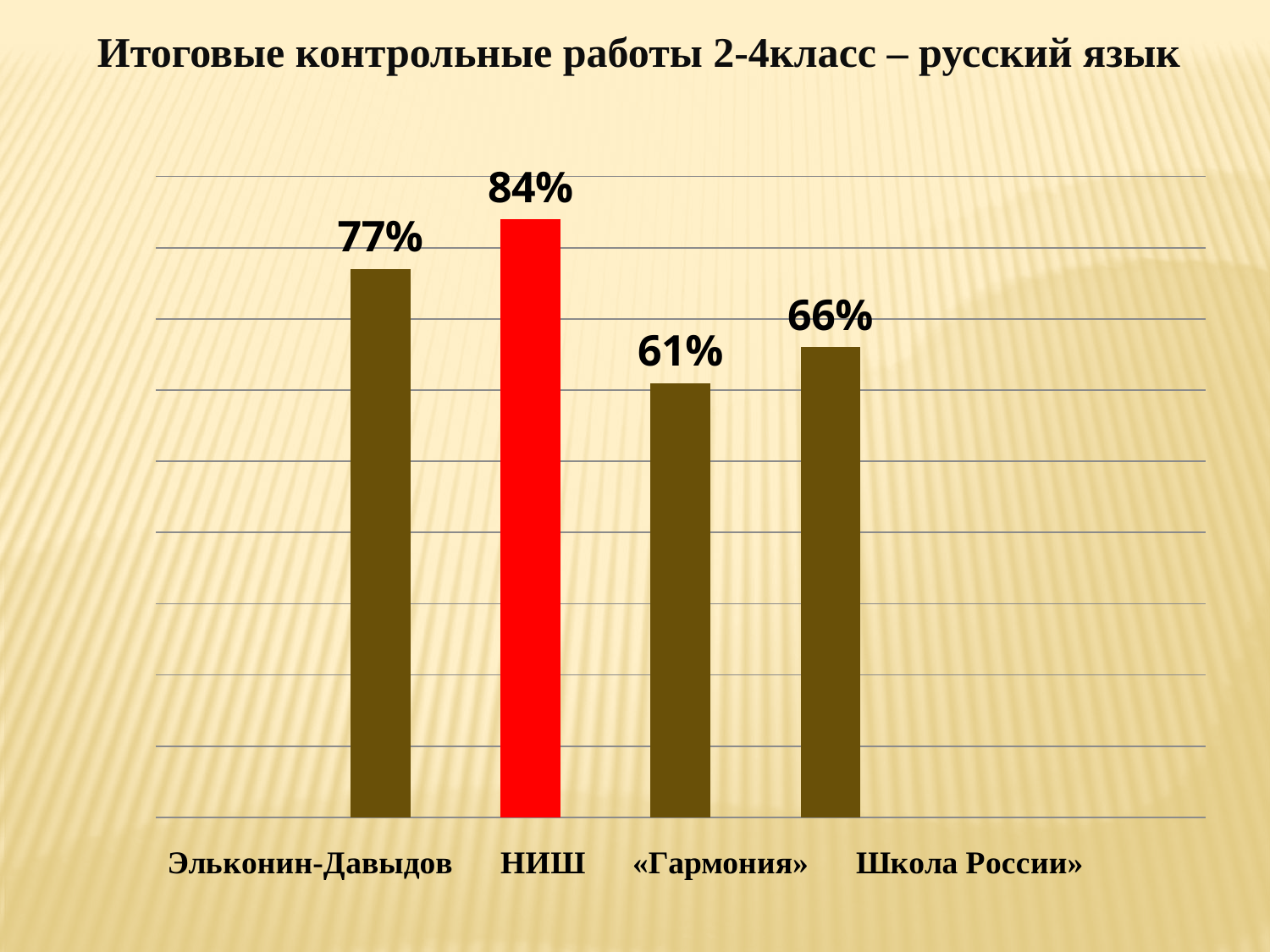
What is the difference between the values for НИШ and Эльконин-Давыдов? 7% What kind of chart is shown on the slide? bar chart How many categories are shown in the chart? 4 What is the value for «Гармония»? 61% What is the difference between the values for Школа России» and «Гармония»? 5% What is the value for Эльконин-Давыдов? 77% What is the value for Школа России»? 66% Which is larger, the value for Эльконин-Давыдов or the value for Школа России»? Эльконин-Давыдов What is the value for НИШ? 84% Which category has the highest value? НИШ Which category has the lowest value? «Гармония» Which bar is coloured red? НИШ